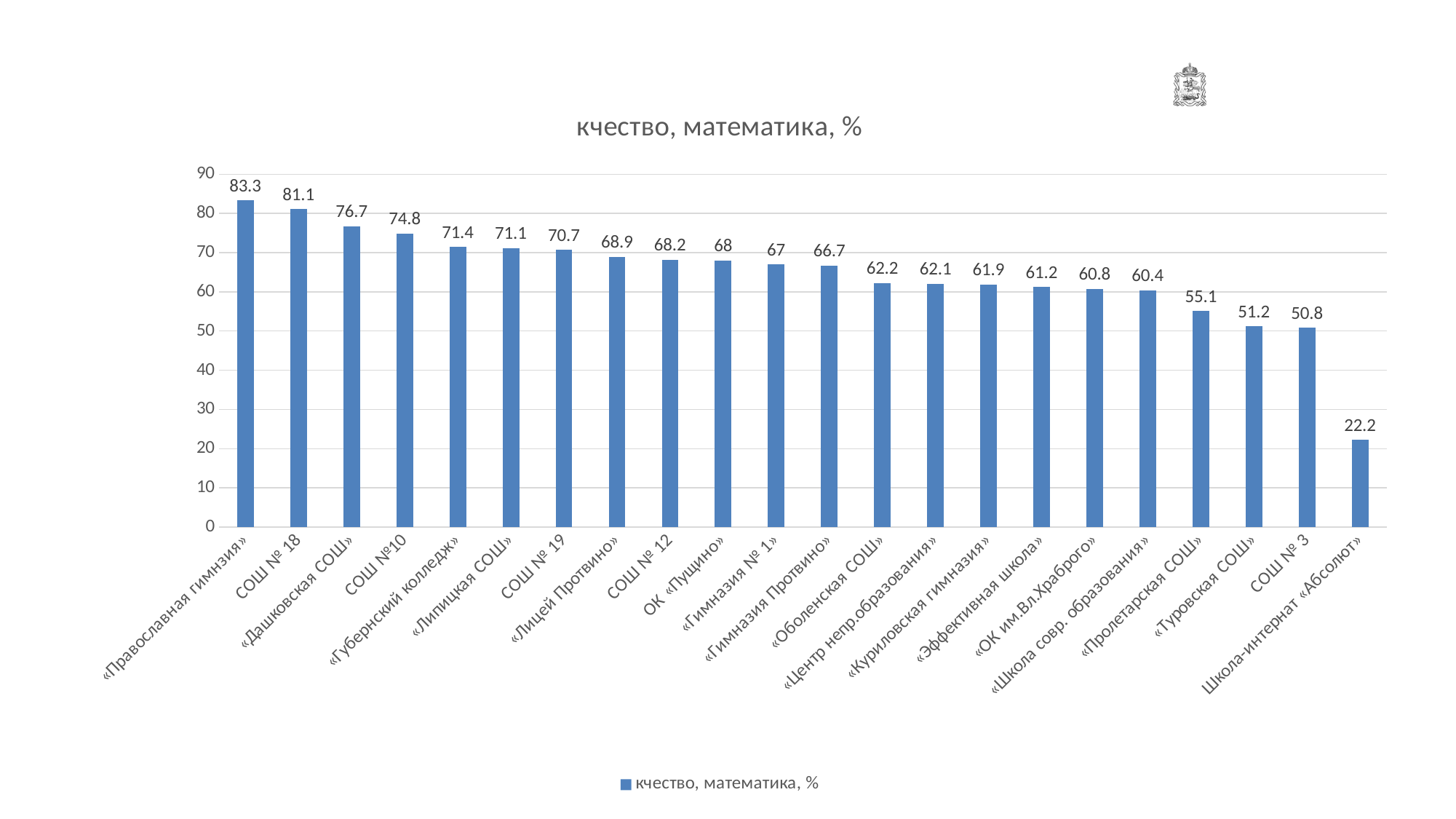
Which is larger, the value for «Губернский колледж» or the value for «Гимназия Протвино»? «Губернский колледж» What is the difference between the values for СОШ № 18 and СОШ № 3? 30.3 How many series does the legend list? 1 How many categories are shown on the chart? 22 Is the value for «Туровская СОШ» greater or less than 60? less Which category has the highest value? «Православная гимнзия» What is the title of the chart? кчество, математика, % What kind of chart is shown? bar chart What is the value for «Пролетарская СОШ»? 55.1 What is the value for «Лицей Протвино»? 68.9 What is the value for «Дашковская СОШ»? 76.7 Which category has the lowest value? Школа-интернат «Абсолют»